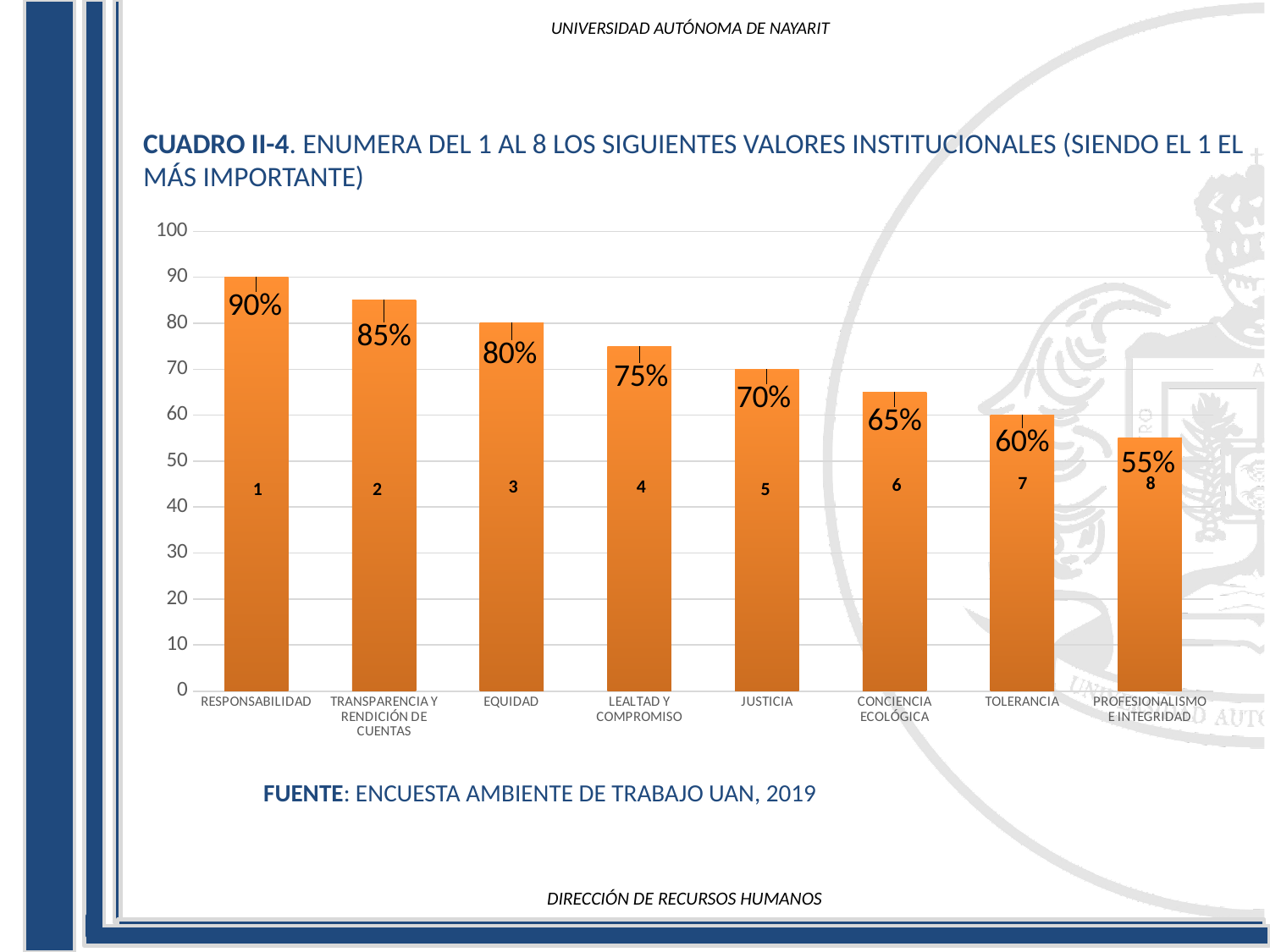
Which category has the lowest value? PROFESIONALISMO E INTEGRIDAD What is the difference between the values for EQUIDAD and TOLERANCIA? 20% What is the value for RESPONSABILIDAD? 90% How many categories are shown on the x axis? 8 Is the value for TRANSPARENCIA Y RENDICIÓN DE CUENTAS greater or less than 80? greater What rank number is printed on the bar for EQUIDAD? 3 What is the value for JUSTICIA? 70% Which category has the highest value? RESPONSABILIDAD What kind of chart is shown on the slide? bar chart What is the value for PROFESIONALISMO E INTEGRIDAD? 55% Which is larger, the value for LEALTAD Y COMPROMISO or the value for CONCIENCIA ECOLÓGICA? LEALTAD Y COMPROMISO Do the values rise or fall from left to right along the x axis? fall